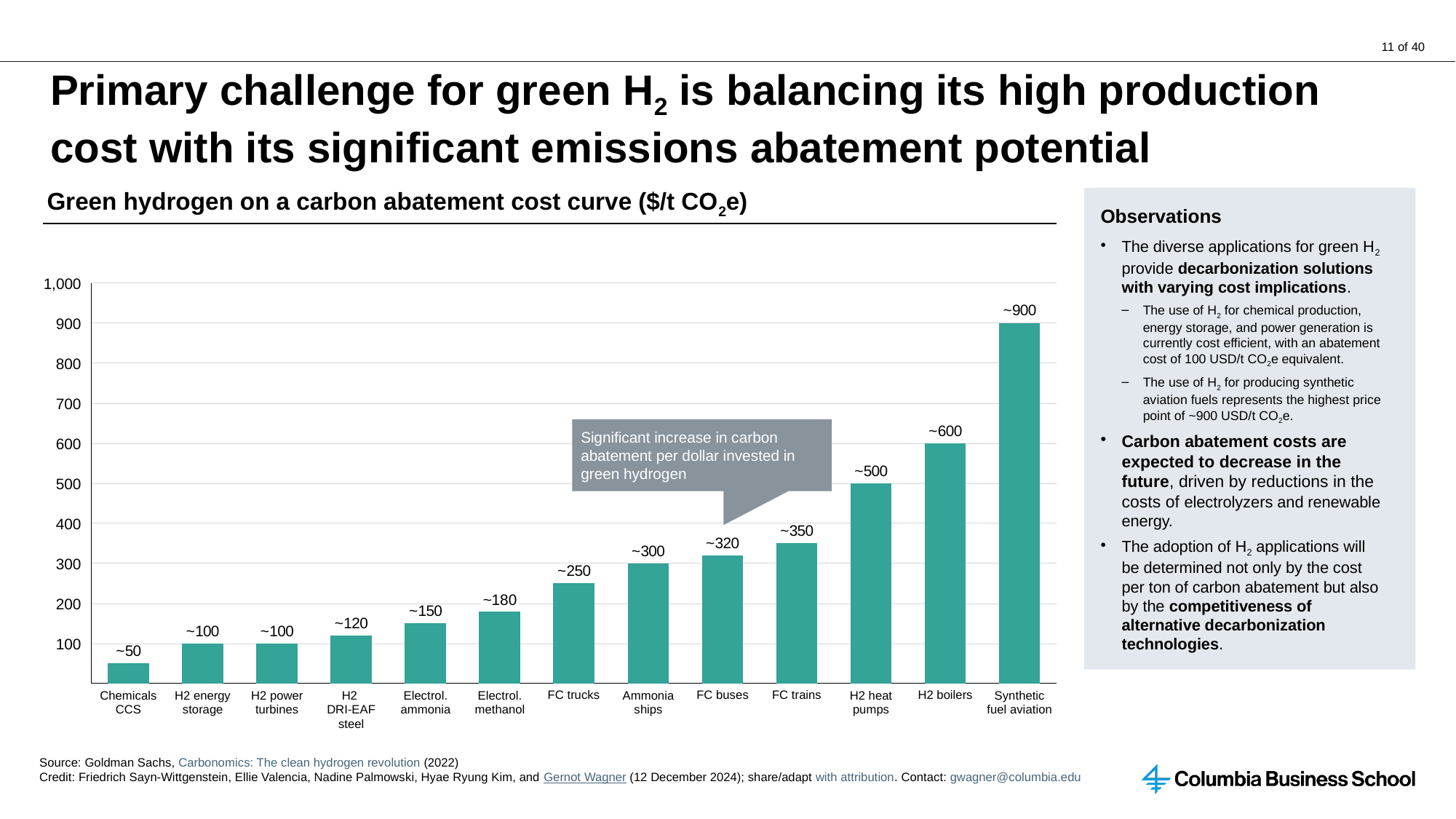
Do the values rise or fall moving from left to right along the x axis? rise Is the value for H2 boilers greater or less than 500? greater How many categories (applications) are plotted on the chart? 13 Is the value for Electrol. ammonia greater or less than 200? less Is the value for Synthetic fuel aviation greater or less than 800? greater Which category has the lowest carbon abatement cost? Chemicals CCS Which is larger, the value for H2 heat pumps or the value for FC trains? H2 heat pumps What is the title of the chart? Green hydrogen on a carbon abatement cost curve ($/t CO2e) What kind of chart is shown on the slide? bar chart Which is larger, the value for Chemicals CCS or the value for H2 DRI-EAF steel? H2 DRI-EAF steel Which category has the highest carbon abatement cost? Synthetic fuel aviation